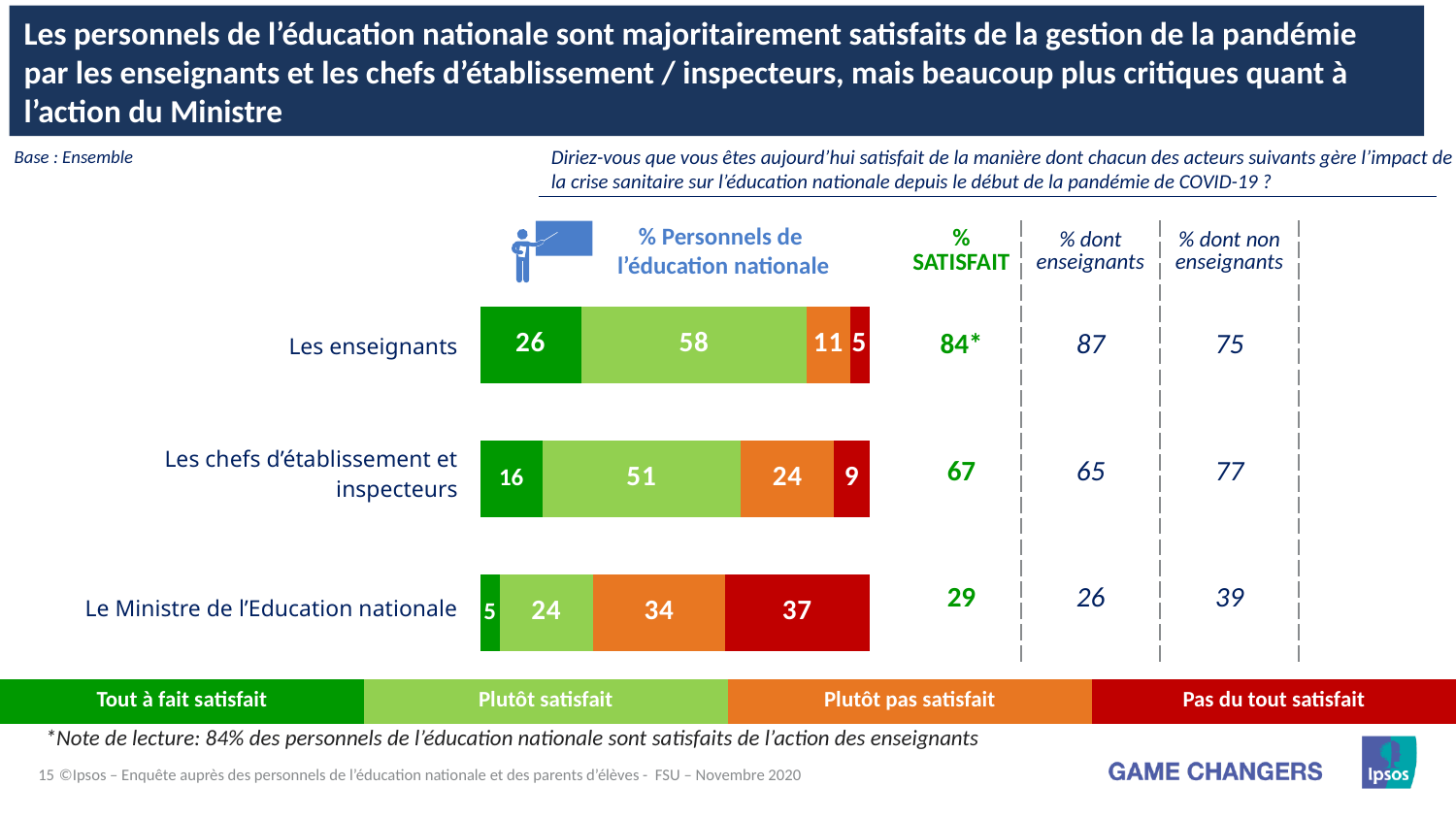
What is the 'Pas du tout satisfait' value for 'Le Ministre de l'Education nationale'? 37 Which is larger: the 'Plutôt satisfait' value for 'Les chefs d'établissement et inspecteurs' or for 'Le Ministre de l'Education nationale'? Les chefs d'établissement et inspecteurs What is the total of 'Tout à fait satisfait' and 'Plutôt satisfait' for 'Les chefs d'établissement et inspecteurs'? 67 What is the 'Tout à fait satisfait' value for 'Les chefs d'établissement et inspecteurs'? 16 Which actor has the lowest '% SATISFAIT' value? Le Ministre de l'Education nationale What type of chart is used to show the satisfaction levels on this slide? Stacked bar chart What colour represents 'Pas du tout satisfait' in the legend? Red What is the difference between the 'Plutôt pas satisfait' values for 'Le Ministre de l'Education nationale' and 'Les enseignants'? 23 How many series does the legend list? 4 How many categories (actors) are shown in the chart? 3 Which actor has the highest 'Tout à fait satisfait' value? Les enseignants What is the 'Plutôt satisfait' value for 'Les enseignants'? 58